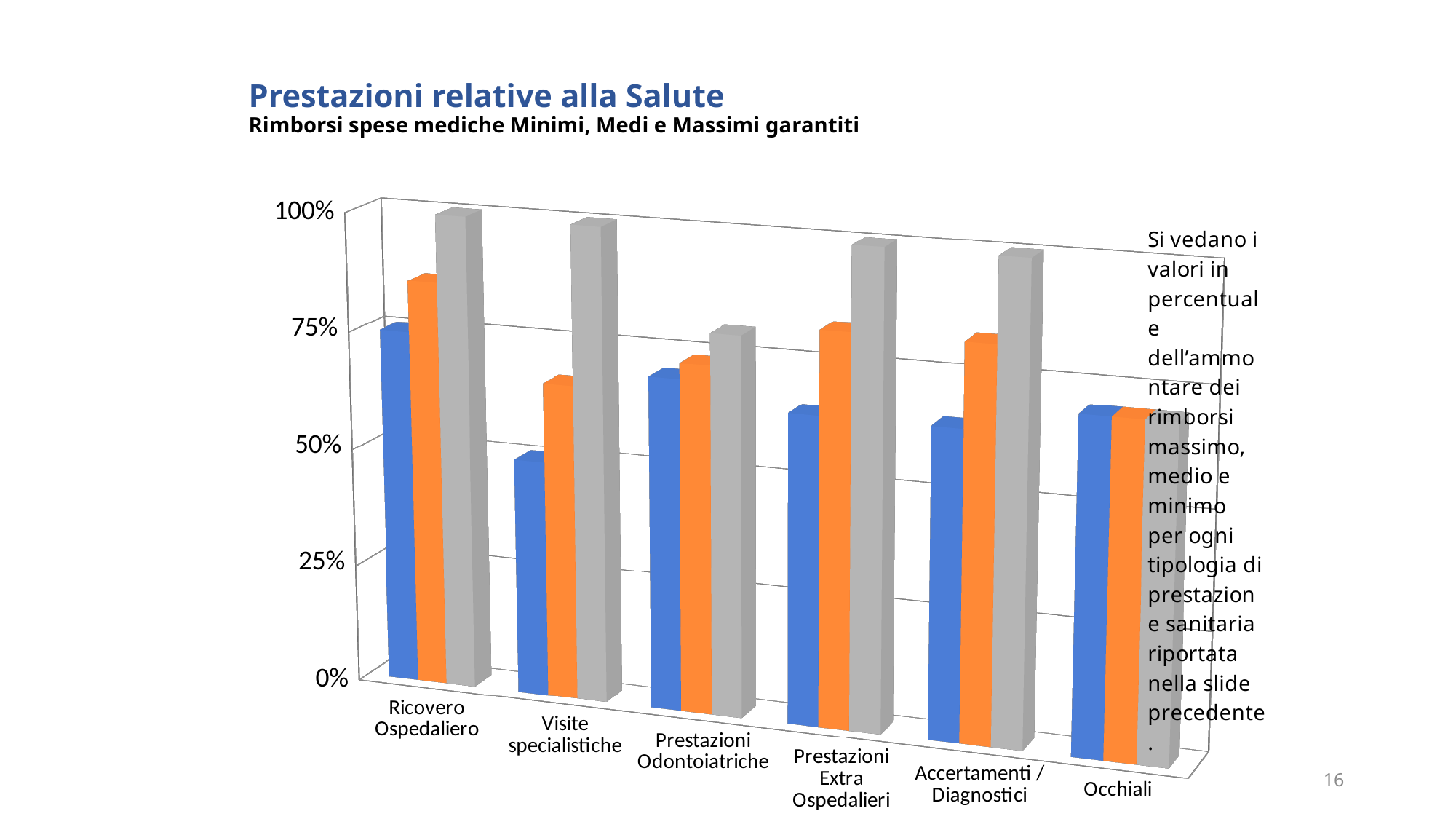
How many categories are shown on the x axis of the chart? 6 How many bars are plotted for each category in the chart? 3 Which is larger: the grey bar for Ricovero Ospedaliero or the grey bar for Prestazioni Odontoiatriche? Ricovero Ospedaliero Which category has the highest blue bar? Ricovero Ospedaliero Which is larger: the orange bar for Visite specialistiche or the orange bar for Ricovero Ospedaliero? Ricovero Ospedaliero Is the value of the blue bar for Visite specialistiche greater or less than 75%? less Is the value of the grey bar for Ricovero Ospedaliero greater or less than 75%? greater Which category has the lowest blue bar? Visite specialistiche What is the title of the slide containing the chart? Prestazioni relative alla Salute Is the value of the grey bar for Occhiali greater or less than 75%? less What kind of chart is shown on the slide? bar chart